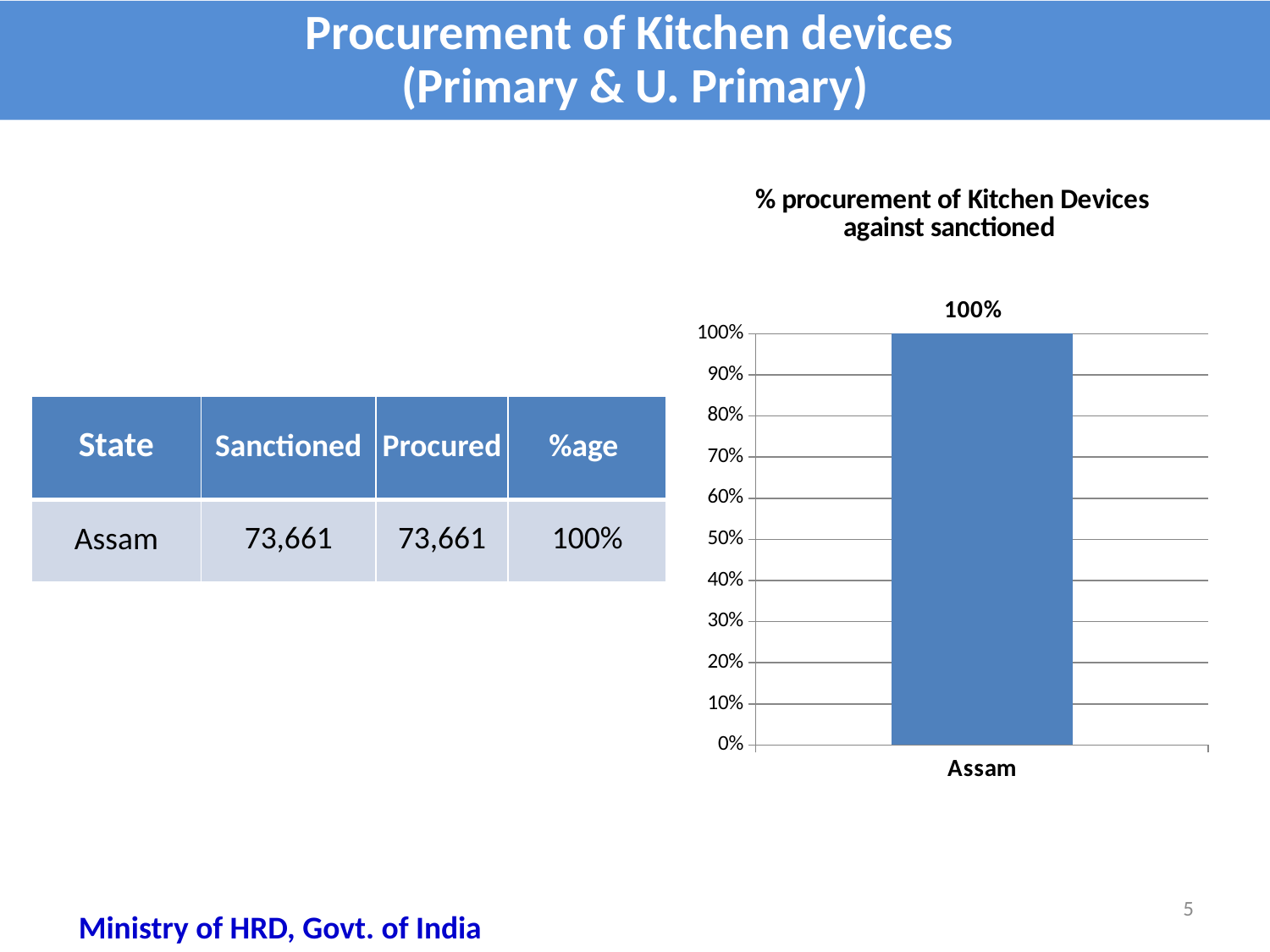
What kind of chart is shown on the slide? bar chart What is the value for Assam in the chart? 100% How many categories are plotted in the chart? 1 What is the title of the chart? % procurement of Kitchen Devices against sanctioned Which state is shown on the x axis of the chart? Assam What is the highest value shown on the chart's y axis? 100% Is the value for Assam greater or less than 50%? greater